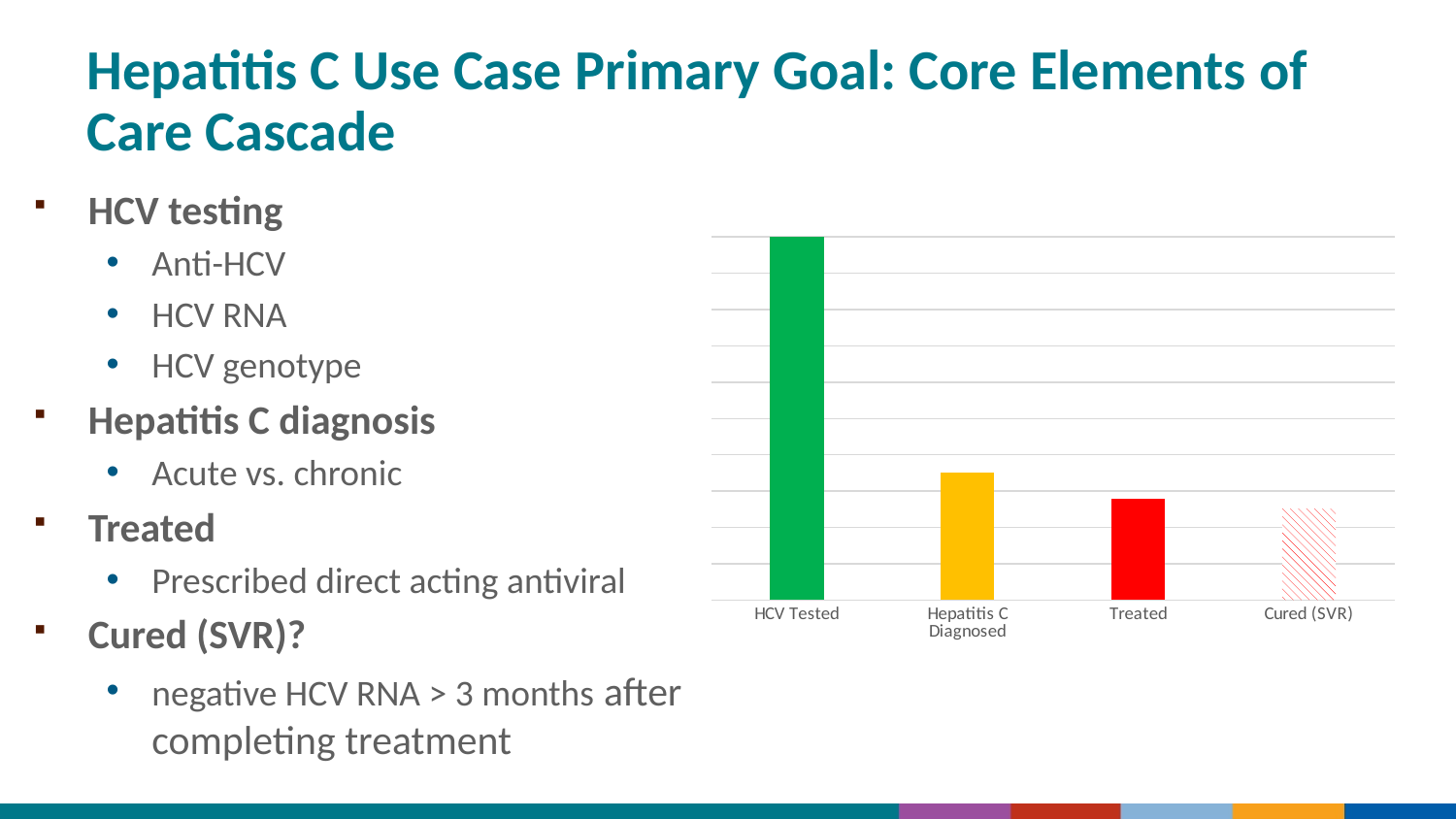
What kind of chart is shown on the slide? bar chart Which bar is taller, Treated or Cured (SVR)? Treated Do the bar heights rise or fall from left to right along the x axis? fall What colour is the HCV Tested bar? green What is the label of the first category on the x axis? HCV Tested Which bar is taller, Hepatitis C Diagnosed or Treated? Hepatitis C Diagnosed Which category has the shortest bar in the chart? Cured (SVR) Which category has the tallest bar in the chart? HCV Tested How many categories are shown on the x axis of the chart? 4 Which bar is taller, HCV Tested or Hepatitis C Diagnosed? HCV Tested